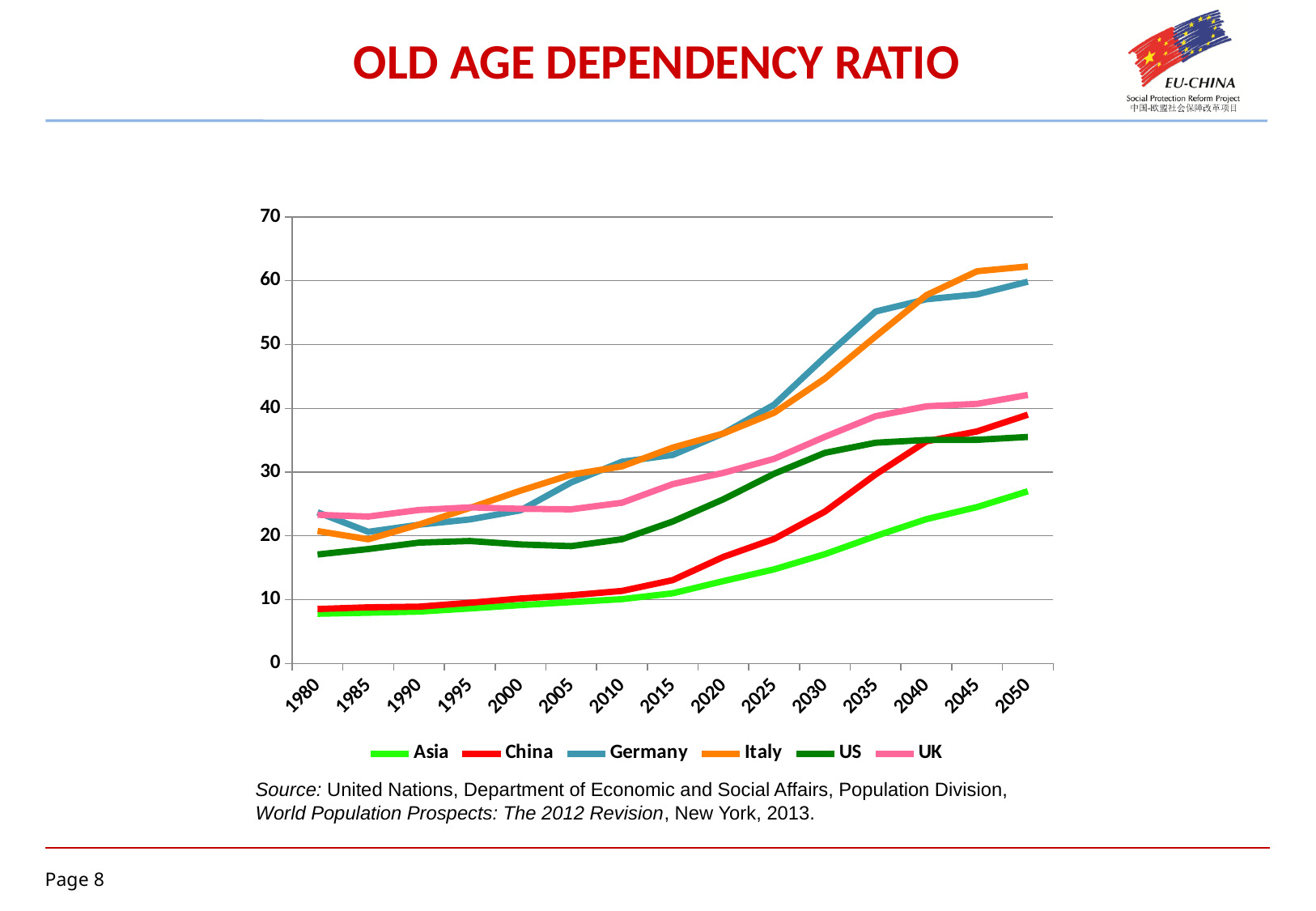
How many years are marked along the x axis? 15 In 2030, which is larger, the value for Germany or the value for the US? Germany Is the value for Asia in 1980 greater or less than 10? less Is the value for Germany in 2035 greater or less than 50? greater Which series has the lowest value in 2050? Asia Does the value for Asia rise or fall from 1980 to 2050? Rise How many series does the legend list? 6 What is the title of the slide's chart? OLD AGE DEPENDENCY RATIO Is the value for the US in 2050 greater or less than 40? less Which series has the highest value in 2035? Germany What kind of chart is shown on the slide? Line chart